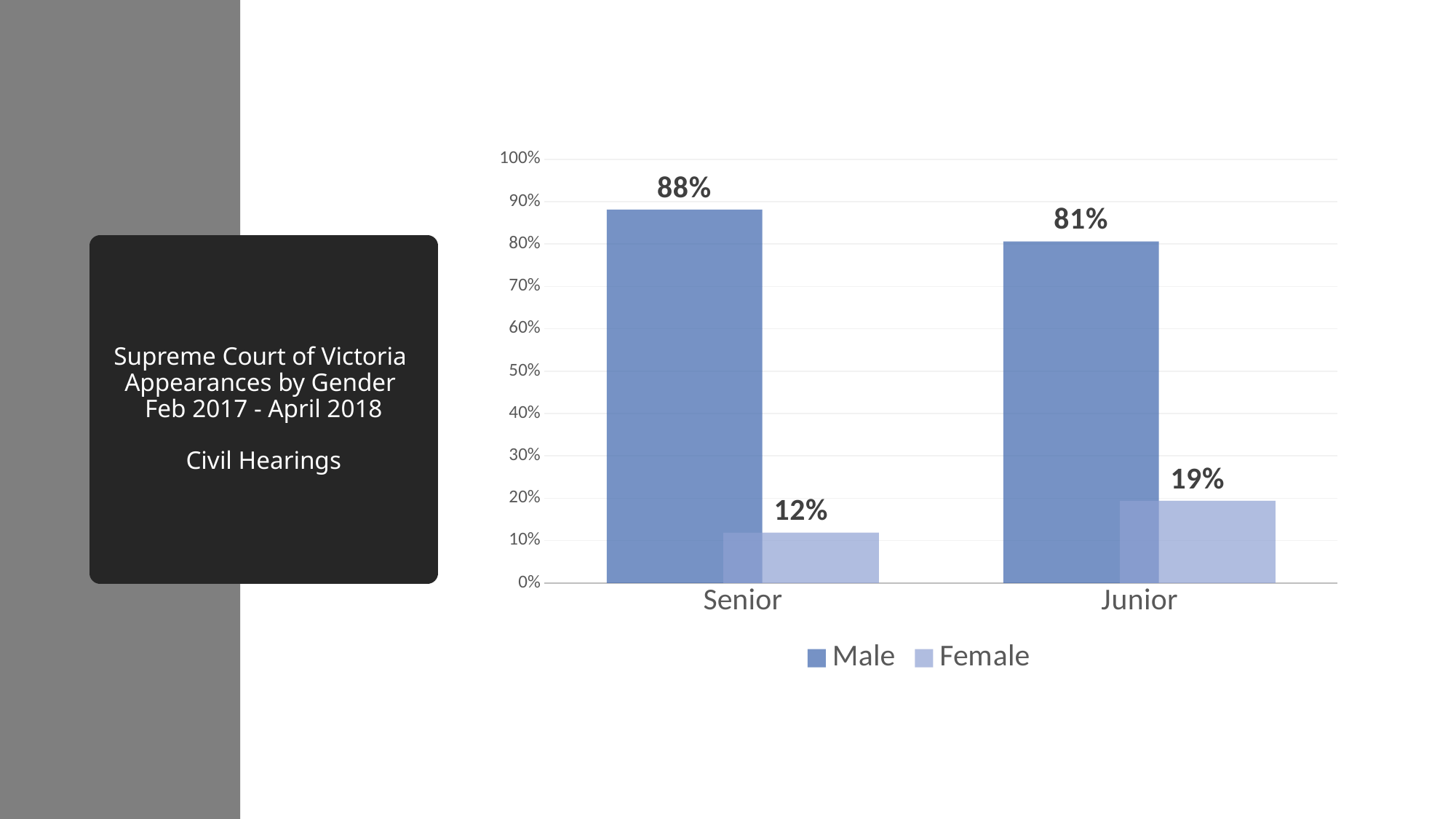
What is the Female value for Senior? 12% Which category has the highest Male value? Senior Which category has the lowest Female value? Senior What is the Male value for Junior? 81% What is the Male value for Senior? 88% What kind of chart is shown on the slide? Bar chart What is the Female value for Junior? 19% What is the difference between the Female values for Junior and Senior? 7% Which is larger, the Male value for Junior or the Male value for Senior? Senior How many categories are shown on the x axis? 2 How many series does the legend list? 2 What is the difference between the Male and Female values for Senior? 76%